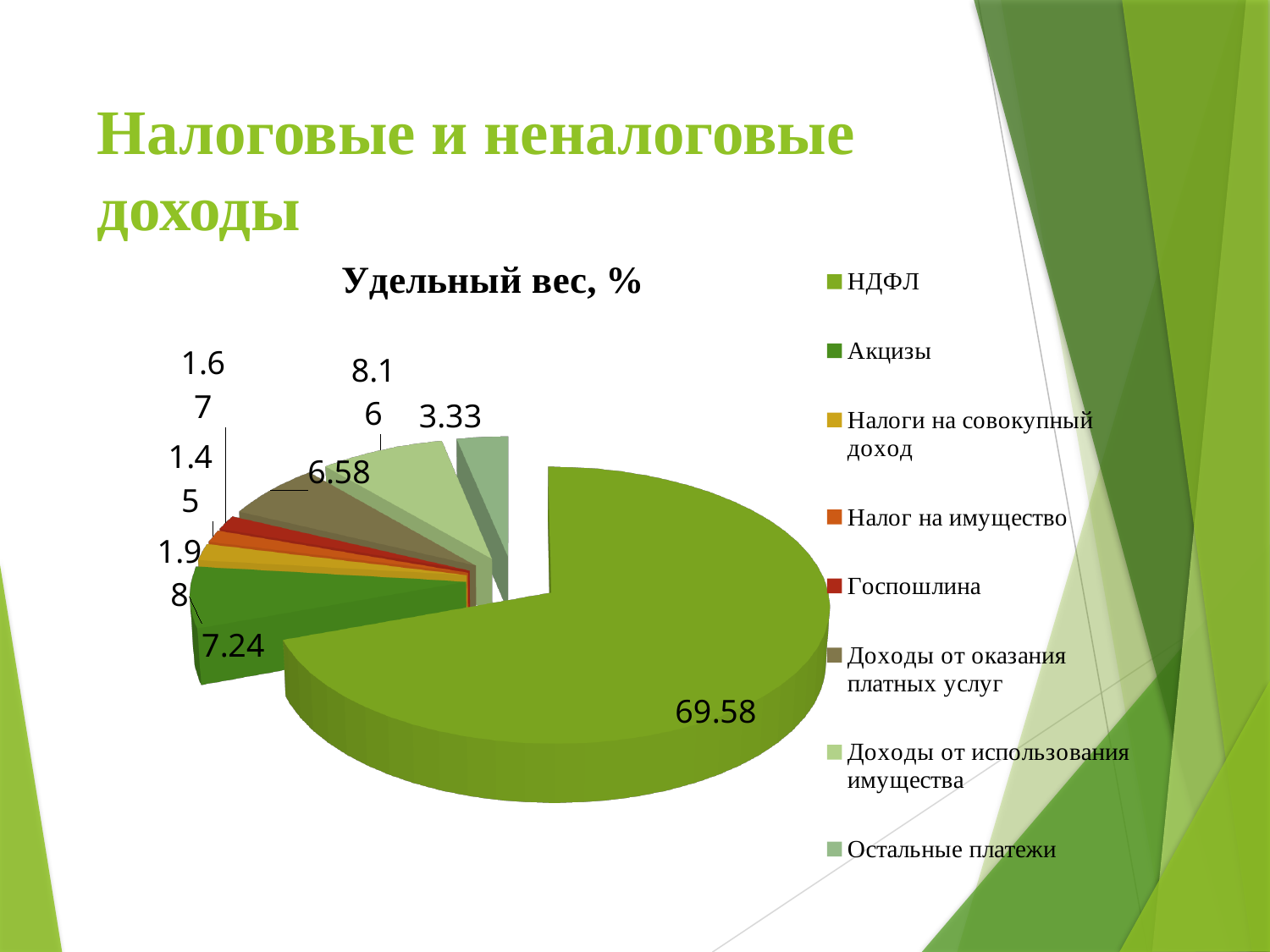
What is the value for НДФЛ in the pie chart? 69.58 Which is larger, Акцизы or Доходы от оказания платных услуг? Акцизы How many categories does the legend of the pie chart list? 8 What is the value for Остальные платежи? 3.33 What is the difference between the values for НДФЛ and Акцизы? 62.34 What is the value for Доходы от оказания платных услуг? 6.58 What is the value for Акцизы in the pie chart? 7.24 What is the title of the pie chart? Удельный вес, % Which category has the largest share of the pie? НДФЛ What is the difference between the values for Акцизы and Остальные платежи? 3.91 Which is larger, Остальные платежи or Доходы от оказания платных услуг? Доходы от оказания платных услуг What kind of chart is shown on the slide? pie chart